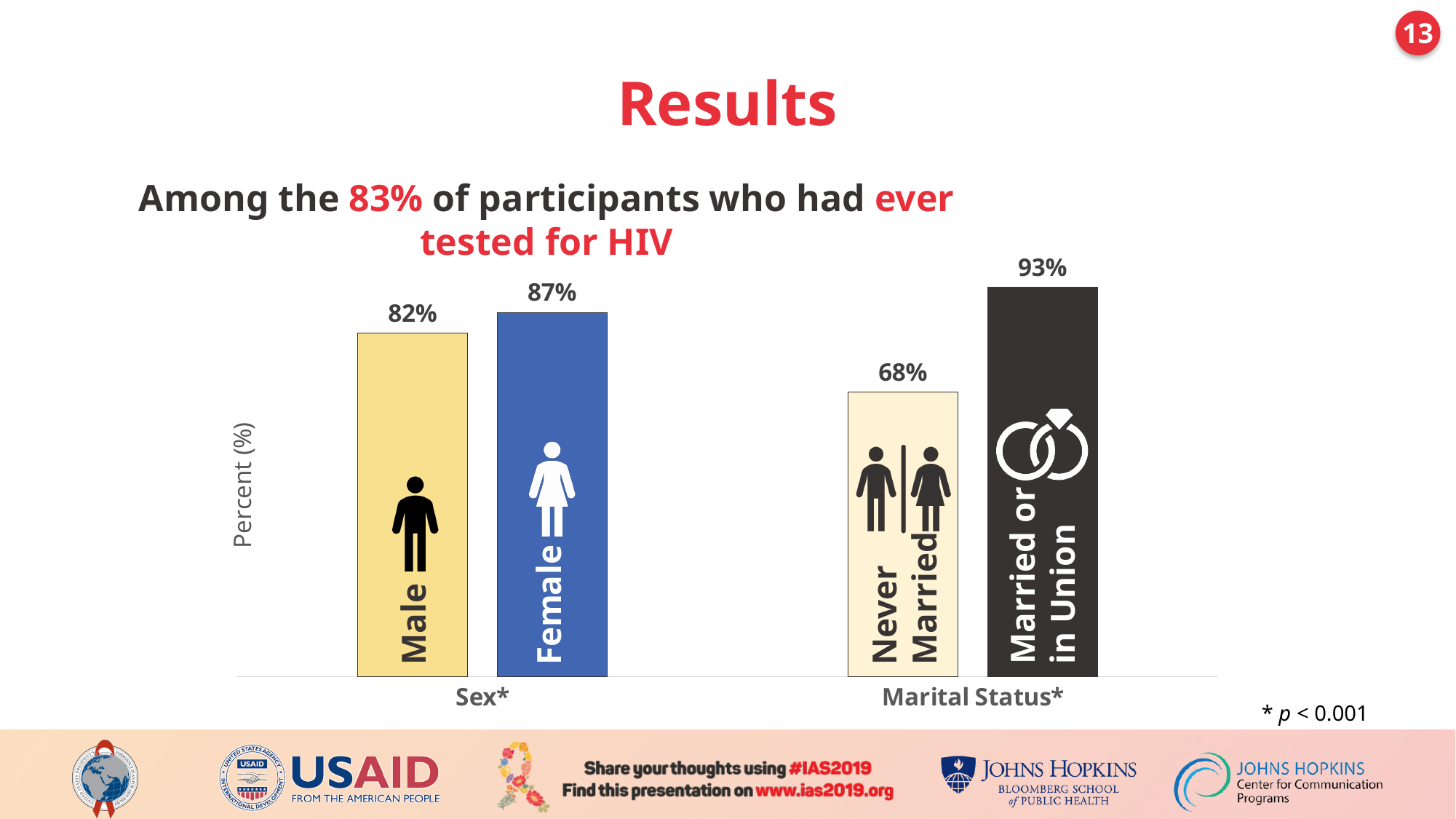
What is the difference between the values for Married or in Union and Never Married? 25% What kind of chart is shown on the slide? Bar chart What is the difference between the values for Female and Male? 5% Which category has the highest value? Married or in Union Which is larger, the value for Male or the value for Female? Female What is the label of the y axis? Percent (%) How many bars are shown in the chart? 4 What is the value for Female? 87% What is the value for Never Married? 68% What is the value for Married or in Union? 93% Which category has the lowest value? Never Married What is the value for Male? 82%